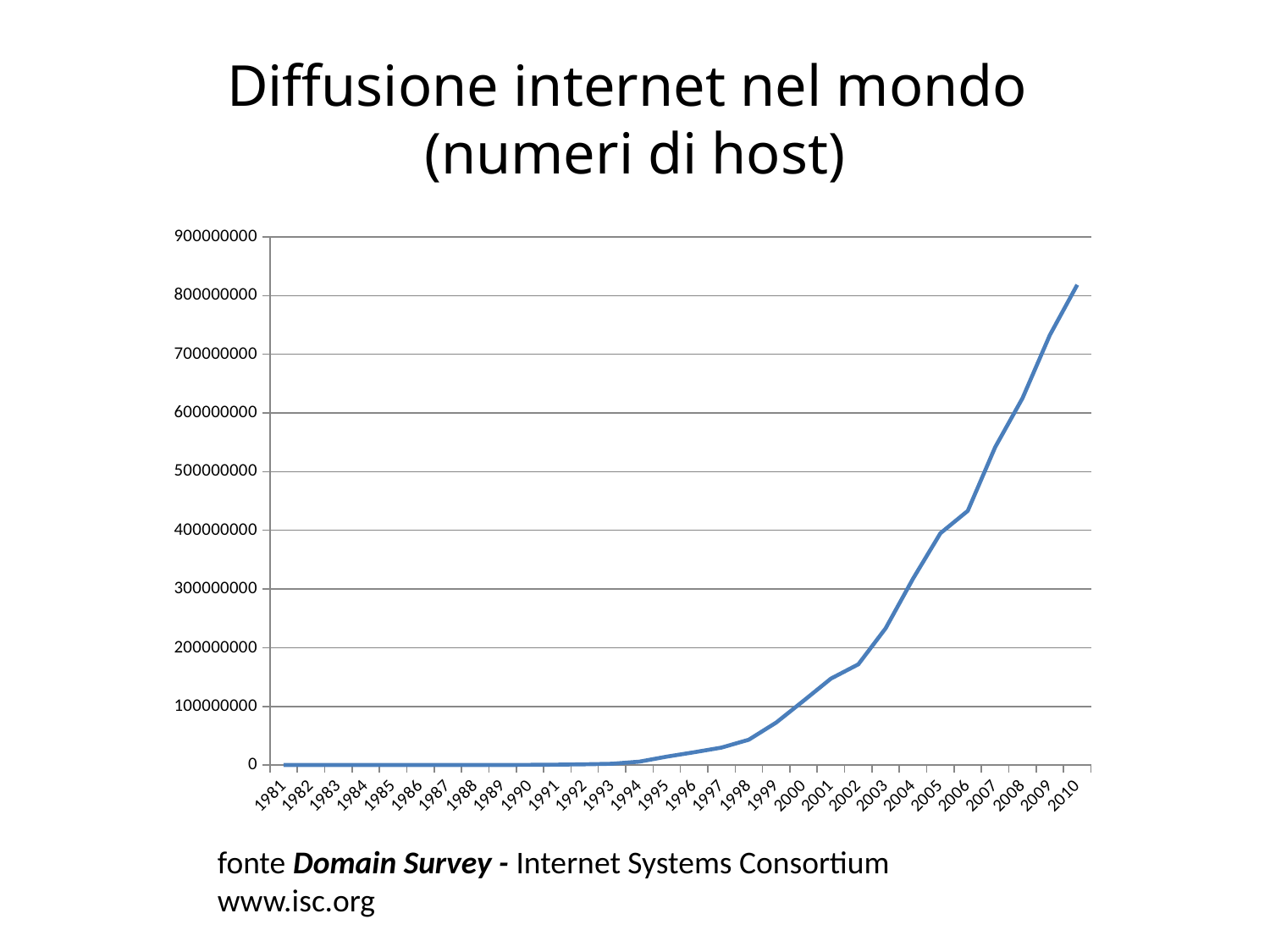
How many years are plotted along the x axis? 30 What is the highest value shown on the y axis? 900000000 Which year has the highest number of hosts? 2010 Which year has the larger value, 2005 or 2010? 2010 Is the value for 1999 greater or less than 100000000? less Do the values rise or fall from 1981 to 2010? rise Is the value for 2002 greater or less than 200000000? less Is the value for 2006 greater or less than 400000000? greater What kind of chart is shown on the slide? line chart What is the title of the chart on the slide? Diffusione internet nel mondo (numeri di host)